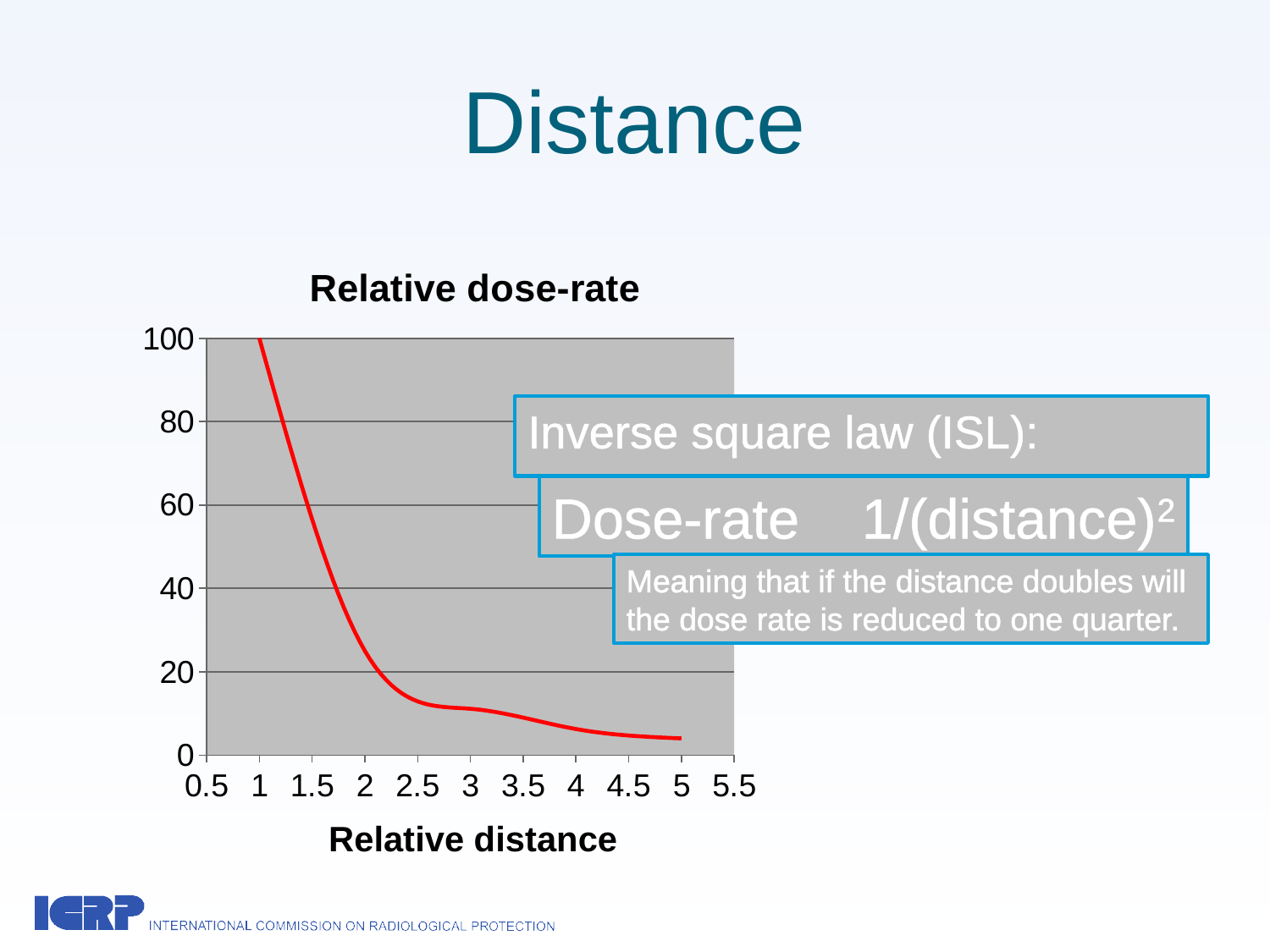
Is the relative dose-rate at a relative distance of 2 greater or less than 40? less What kind of chart is shown on the slide? line chart Is the relative dose-rate at a relative distance of 5 greater or less than 20? less At which relative distance shown is the relative dose-rate highest? 1 How many lines are plotted on the chart? 1 Is the relative dose-rate at a relative distance of 3 greater or less than 20? less What is the title of the chart? Relative dose-rate What is the relative dose-rate at a relative distance of 1? 100 Does the relative dose-rate rise or fall as relative distance increases? fall Which has the larger relative dose-rate, a relative distance of 2 or a relative distance of 4? 2 What is the label of the x axis of the chart? Relative distance